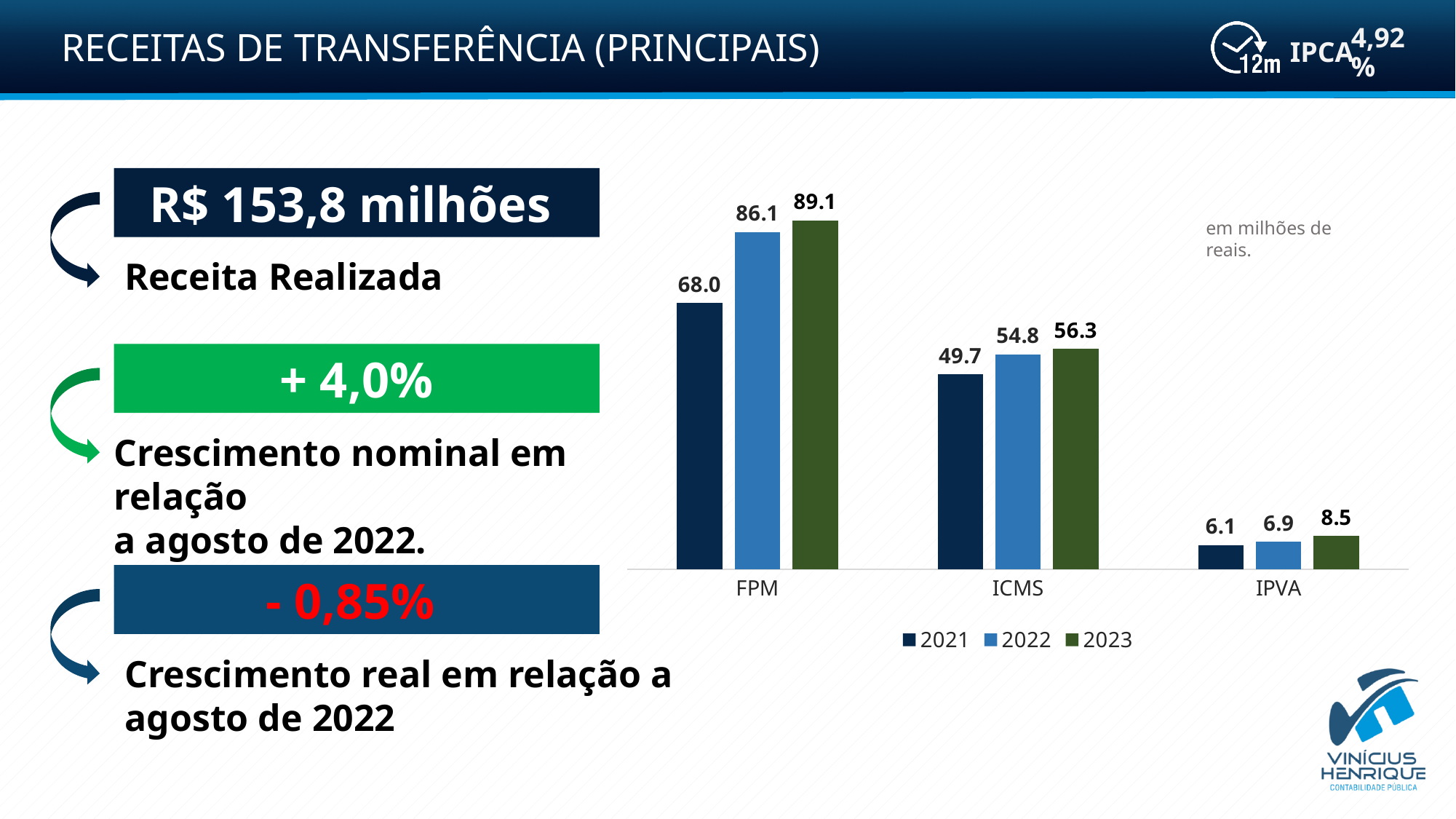
Do the values for IPVA rise or fall from 2021 to 2023? rise What is the value for FPM in 2023? 89.1 What is the value for IPVA in 2022? 6.9 Which category has the highest value in 2022? FPM What kind of chart is shown on the slide? bar chart Which category has the lowest value in 2021? IPVA How many series does the legend list? 3 What is the difference between the 2023 and 2022 values for ICMS? 1.5 What is the difference between the 2023 and 2021 values for FPM? 21.1 How many categories are shown on the x axis? 3 Which is larger: the 2022 value for ICMS or the 2021 value for FPM? 2021 value for FPM What is the value for ICMS in 2021? 49.7